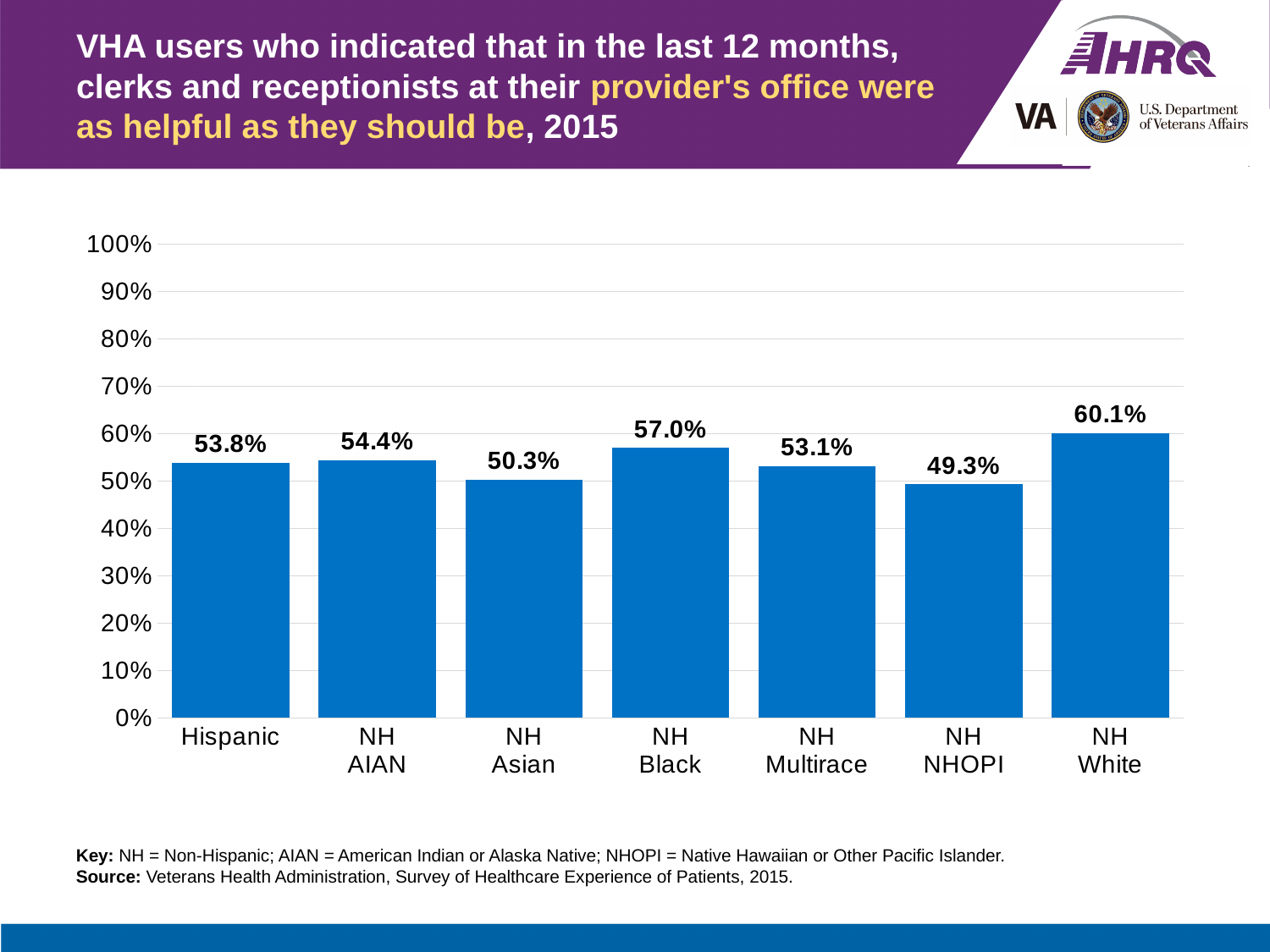
What is the difference in percentage points between NH Black and NH Multirace? 3.9 Which is larger, the value for NH AIAN or the value for NH Asian? NH AIAN How many racial/ethnic groups are shown in the chart? 7 What is the difference in percentage points between NH White and NH NHOPI? 10.8 What type of chart is shown on the slide? Bar chart What is the value shown for NH NHOPI? 49.3% What percentage of Hispanic VHA users indicated that clerks and receptionists were as helpful as they should be? 53.8% Which group has the lowest percentage? NH NHOPI According to the key, what does NHOPI stand for? Native Hawaiian or Other Pacific Islander Is the value for NH Black greater or less than 50%? greater Which group has the highest percentage? NH White What is the value shown for NH Asian? 50.3%